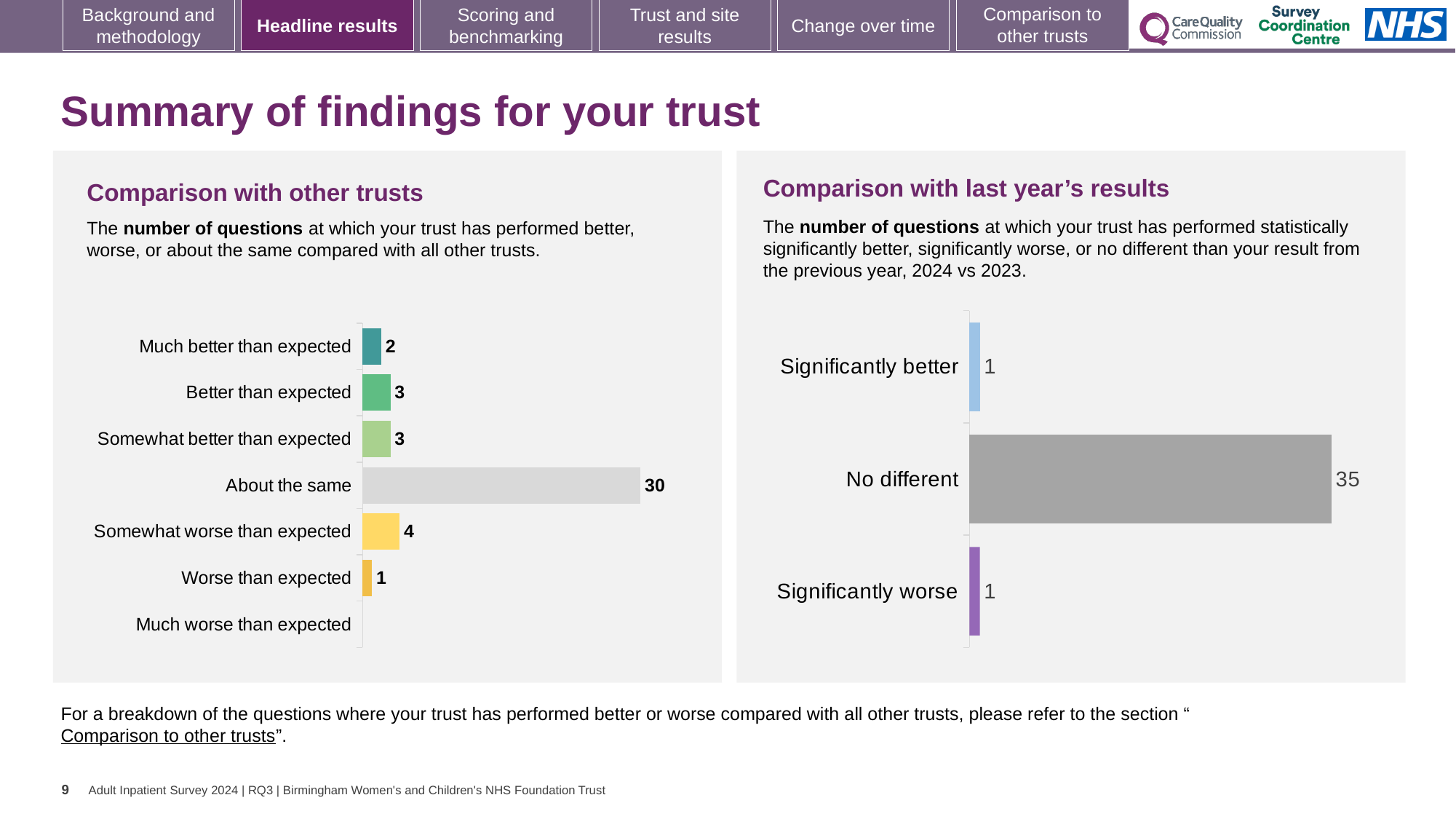
In the 'Comparison with last year's results' chart, what is the value for 'Significantly worse'? 1 In the 'Comparison with other trusts' chart, which is larger: 'Better than expected' or 'Worse than expected'? Better than expected In the 'Comparison with last year's results' chart, what is the value for 'No different'? 35 How many categories are shown in the 'Comparison with last year's results' chart? 3 In the 'Comparison with other trusts' chart, which category has the highest value? About the same In the 'Comparison with last year's results' chart, what is the difference between 'No different' and 'Significantly better'? 34 What kind of chart is the 'Comparison with other trusts' chart? Bar chart In the 'Comparison with other trusts' chart, what is the difference between 'About the same' and 'Somewhat worse than expected'? 26 In the 'Comparison with other trusts' chart, what is the value for 'About the same'? 30 In the 'Comparison with other trusts' chart, what is the value for 'Much better than expected'? 2 How many categories are listed in the 'Comparison with other trusts' chart? 7 In the 'Comparison with other trusts' chart, what is the value for 'Somewhat worse than expected'? 4